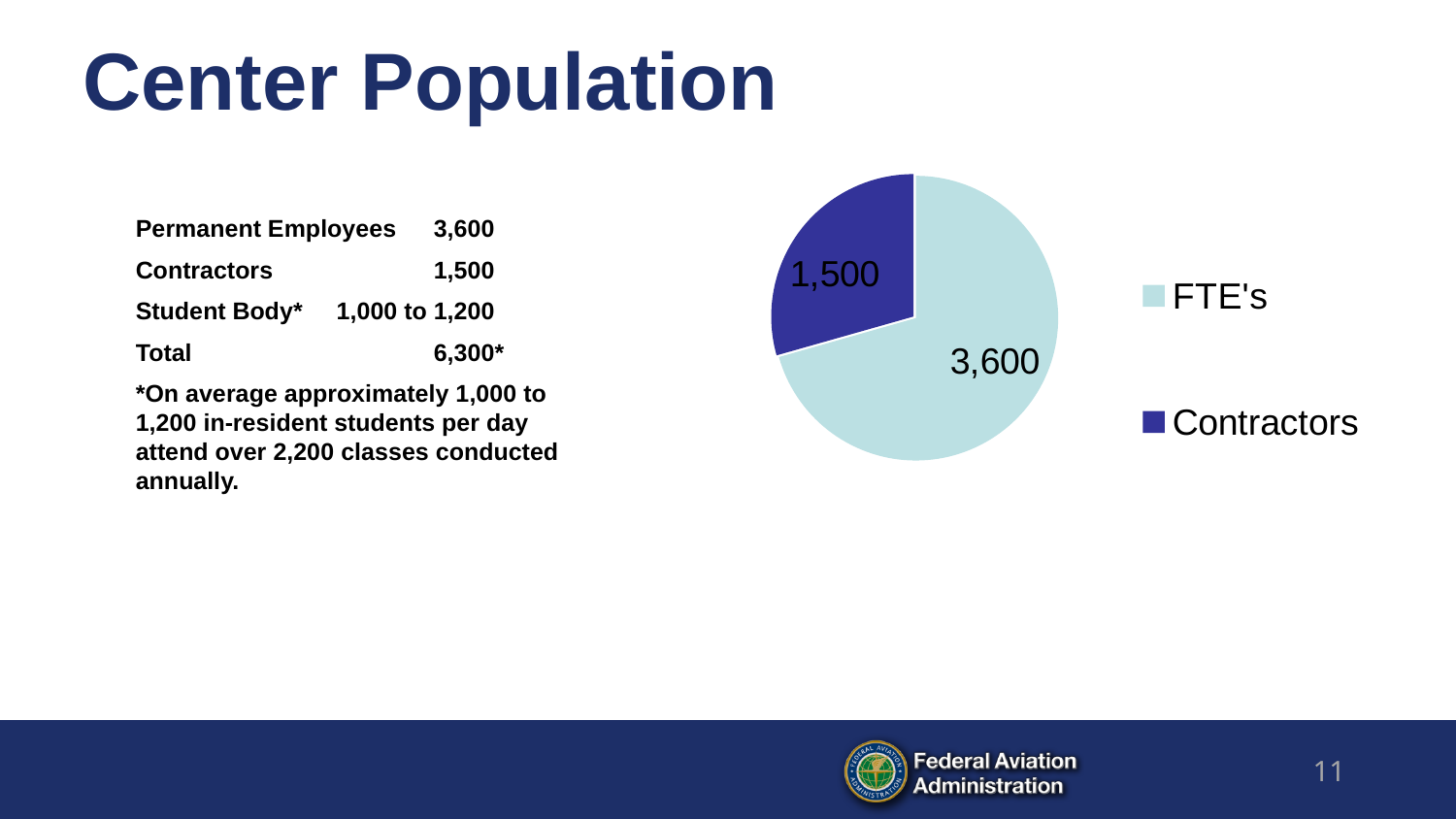
How many slices does the pie chart have? 2 What type of chart is shown on the slide? pie chart What is the difference between the FTE's value and the Contractors value in the pie chart? 2,100 Which slice of the pie chart is the largest? FTE's Which is larger in the pie chart, FTE's or Contractors? FTE's What is the total of the two values shown in the pie chart? 5,100 How many entries does the pie chart legend list? 2 What is the value for Contractors in the pie chart? 1,500 What is the value for FTE's in the pie chart? 3,600 Which slice of the pie chart is the smallest? Contractors What colour is the Contractors slice in the pie chart? dark blue